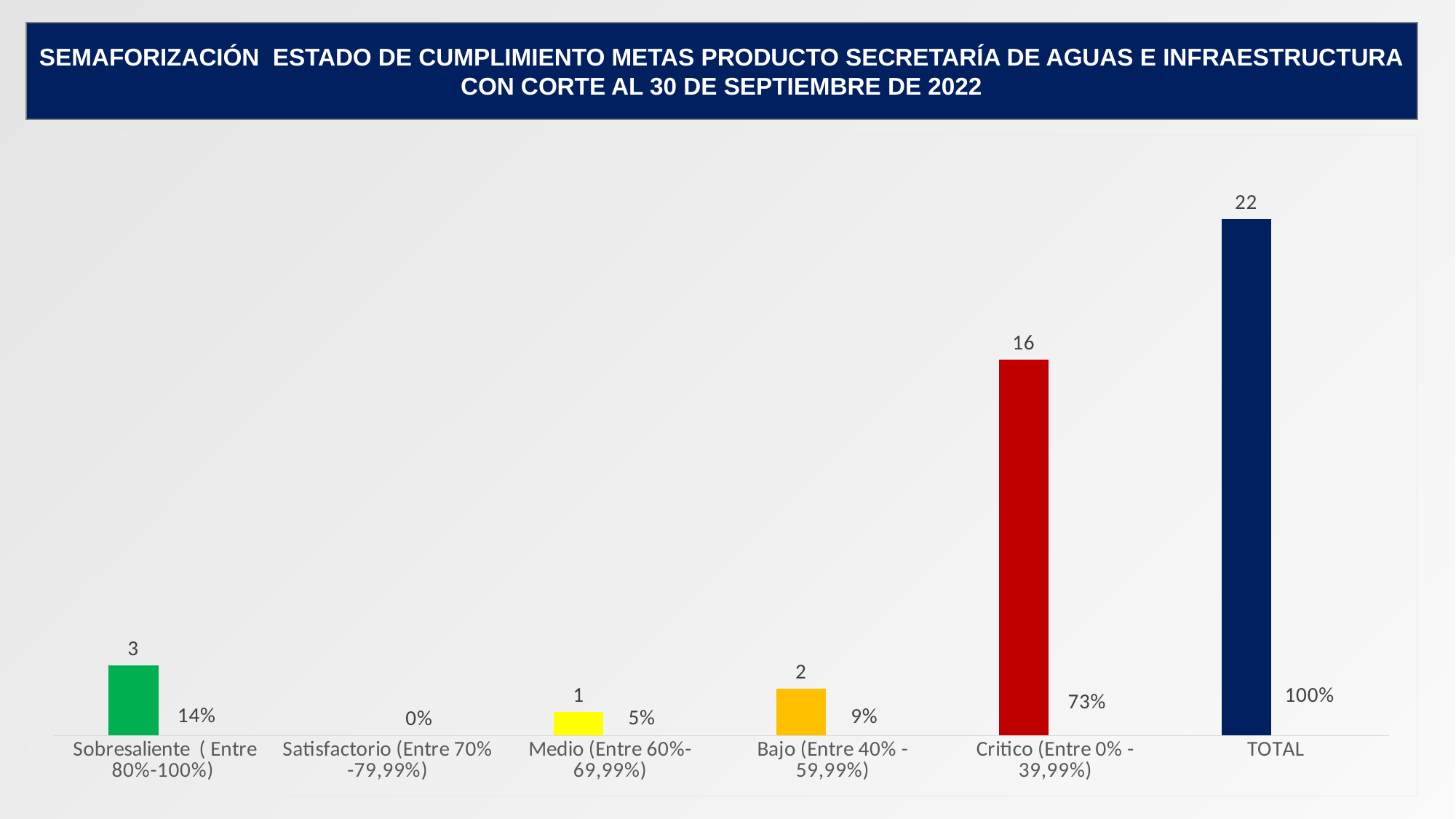
What percentage is shown for the Medio (Entre 60%-69,99%) category? 5% What is the value for the Critico (Entre 0% - 39,99%) category? 16 What is the value for the TOTAL category? 22 What colour is the bar for the Critico (Entre 0% - 39,99%) category? Red What kind of chart is shown on the slide? Bar chart What percentage is shown for the Bajo (Entre 40% - 59,99%) category? 9% What is the value for the Sobresaliente (Entre 80%-100%) category? 3 What is the difference between the values for Critico (Entre 0% - 39,99%) and Sobresaliente (Entre 80%-100%)? 13 How many categories are shown on the x axis? 6 Which is larger, the value for Bajo (Entre 40% - 59,99%) or the value for Medio (Entre 60%-69,99%)? Bajo (Entre 40% - 59,99%) Which category has the lowest value? Satisfactorio (Entre 70% -79,99%) Excluding TOTAL, which category has the highest value? Critico (Entre 0% - 39,99%)